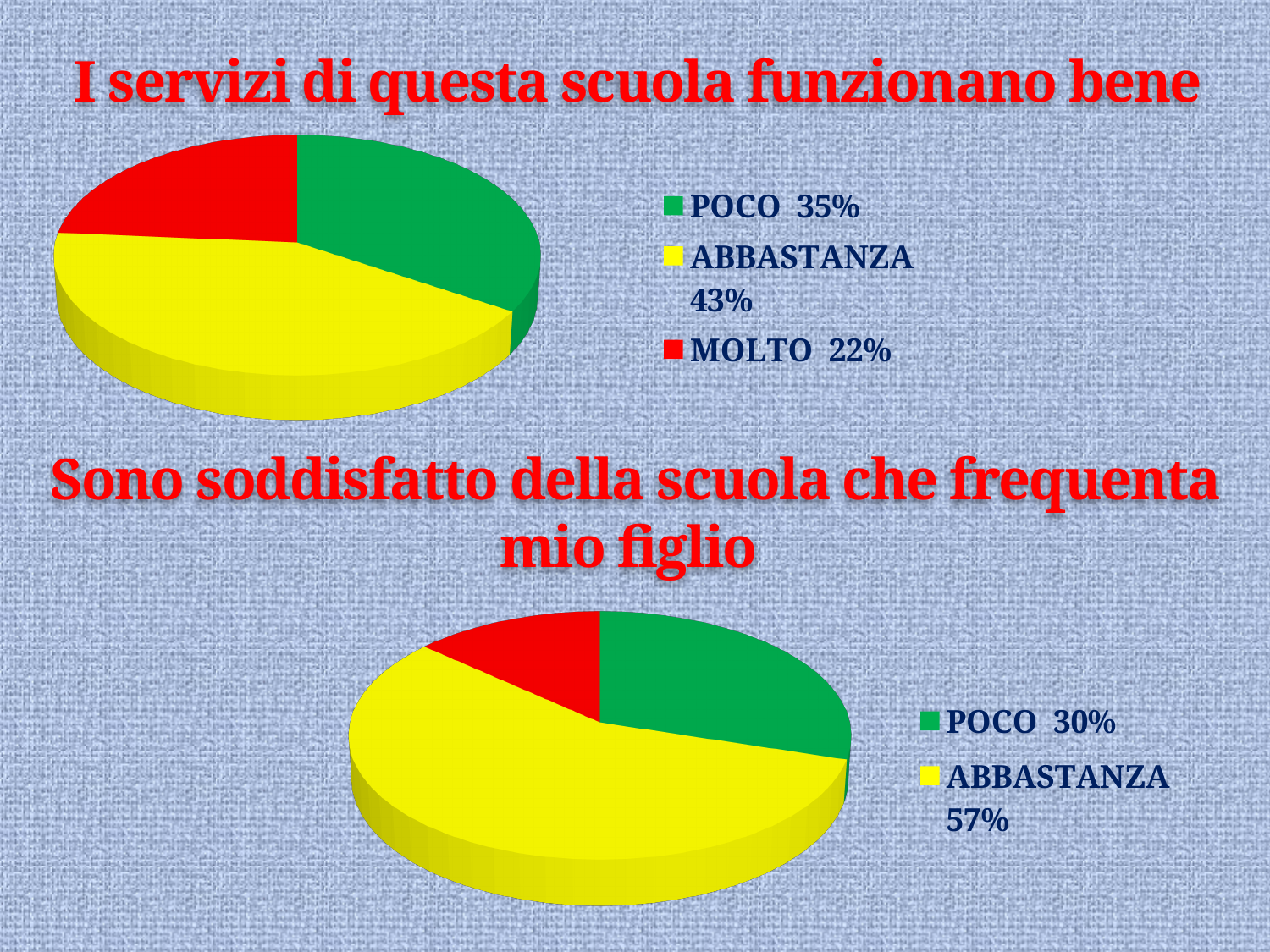
In the chart titled "Sono soddisfatto della scuola che frequenta mio figlio", what percentage is shown for POCO? 30% In the chart titled "Sono soddisfatto della scuola che frequenta mio figlio", how many entries does the legend list? 2 In the chart titled "I servizi di questa scuola funzionano bene", what percentage is shown for MOLTO? 22% In the chart titled "I servizi di questa scuola funzionano bene", which category has the smallest share? MOLTO What kind of chart is used for "I servizi di questa scuola funzionano bene"? Pie chart In the chart titled "I servizi di questa scuola funzionano bene", what colour is the ABBASTANZA slice? Yellow In the chart titled "I servizi di questa scuola funzionano bene", what percentage is shown for ABBASTANZA? 43% In the chart titled "I servizi di questa scuola funzionano bene", how many categories does the legend list? 3 In the chart titled "Sono soddisfatto della scuola che frequenta mio figlio", which is larger, POCO or ABBASTANZA? ABBASTANZA In the chart titled "I servizi di questa scuola funzionano bene", which category has the largest share? ABBASTANZA In the chart titled "Sono soddisfatto della scuola che frequenta mio figlio", what percentage is shown for ABBASTANZA? 57% In the chart titled "I servizi di questa scuola funzionano bene", what is the difference in percentage points between POCO and MOLTO? 13